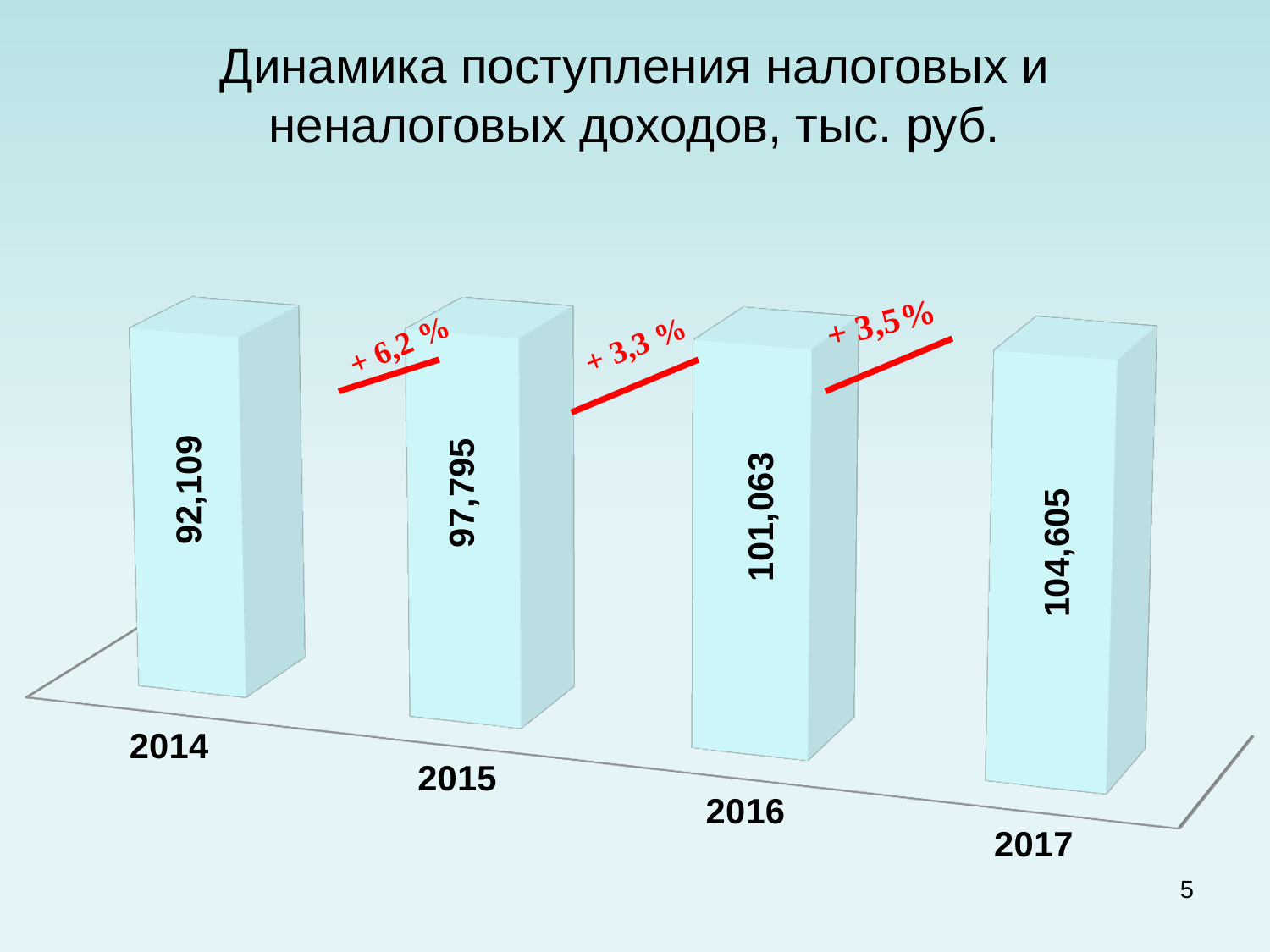
Which is larger, the value for 2016 or the value for 2015? 2016 Which year has the lowest value? 2014 What is the value for 2015? 97,795 What is the value for 2017? 104,605 What is the value for 2014? 92,109 How many years are shown on the chart? 4 What is the difference between the values for 2017 and 2016? 3,542 Do the values rise or fall from 2014 to 2017? rise What kind of chart is shown on the slide? bar chart Which year has the highest value? 2017 What is the difference between the values for 2015 and 2014? 5,686 What is the value for 2016? 101,063